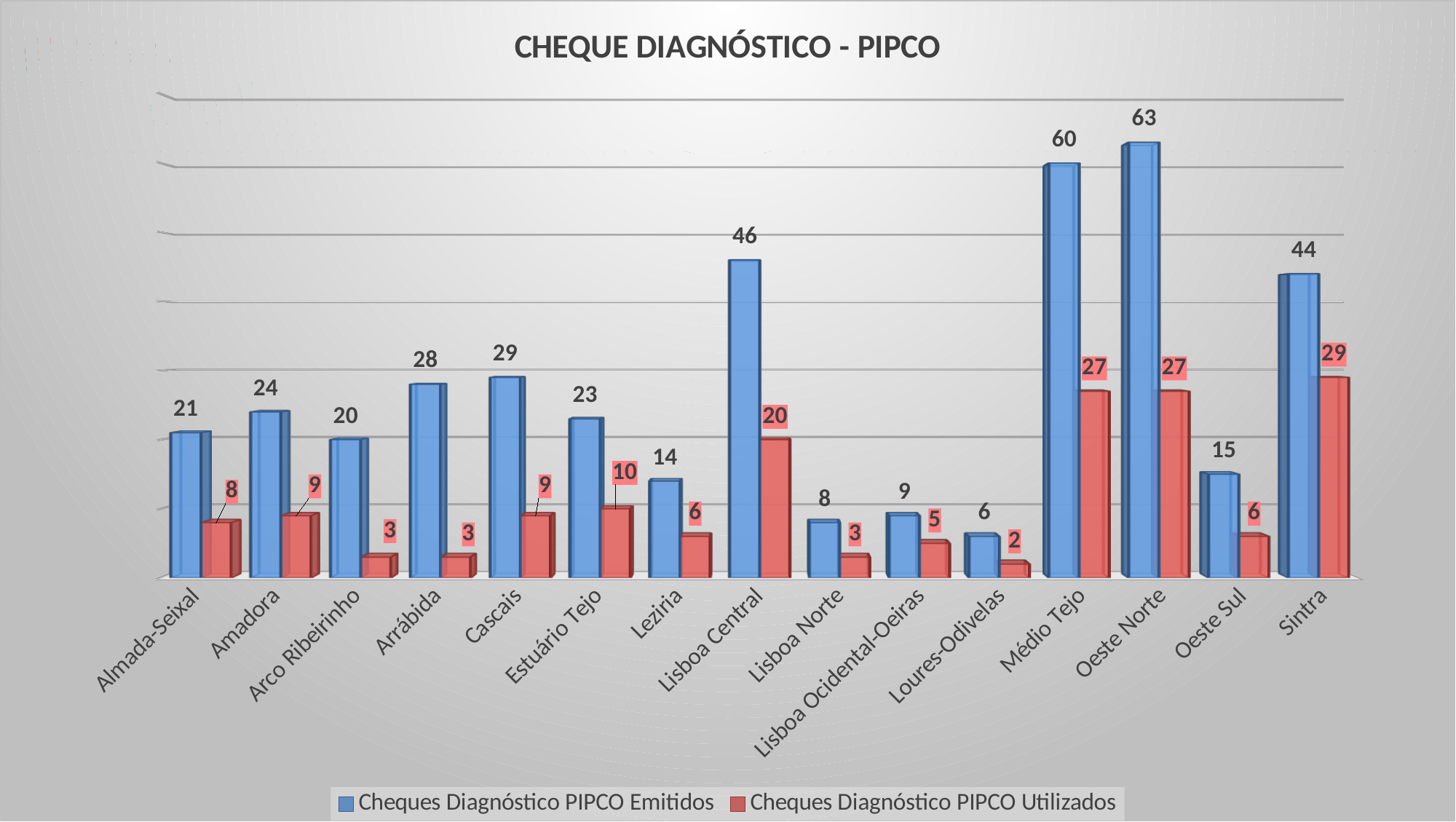
What is the difference between Cheques Diagnóstico PIPCO Emitidos and Cheques Diagnóstico PIPCO Utilizados for Médio Tejo? 33 How many categories are shown on the x axis? 15 Which category has the highest value of Cheques Diagnóstico PIPCO Emitidos? Oeste Norte Which colour represents Cheques Diagnóstico PIPCO Utilizados in the legend? Red What is the value of Cheques Diagnóstico PIPCO Emitidos for Lisboa Central? 46 What is the value of Cheques Diagnóstico PIPCO Utilizados for Sintra? 29 What is the title of the chart? CHEQUE DIAGNÓSTICO - PIPCO How many series does the legend list? 2 Which category has the lowest value of Cheques Diagnóstico PIPCO Utilizados? Loures-Odivelas Which is larger: Cheques Diagnóstico PIPCO Emitidos for Cascais or for Arrábida? Cascais What kind of chart is shown on the slide? Bar chart What is the value of Cheques Diagnóstico PIPCO Utilizados for Estuário Tejo? 10